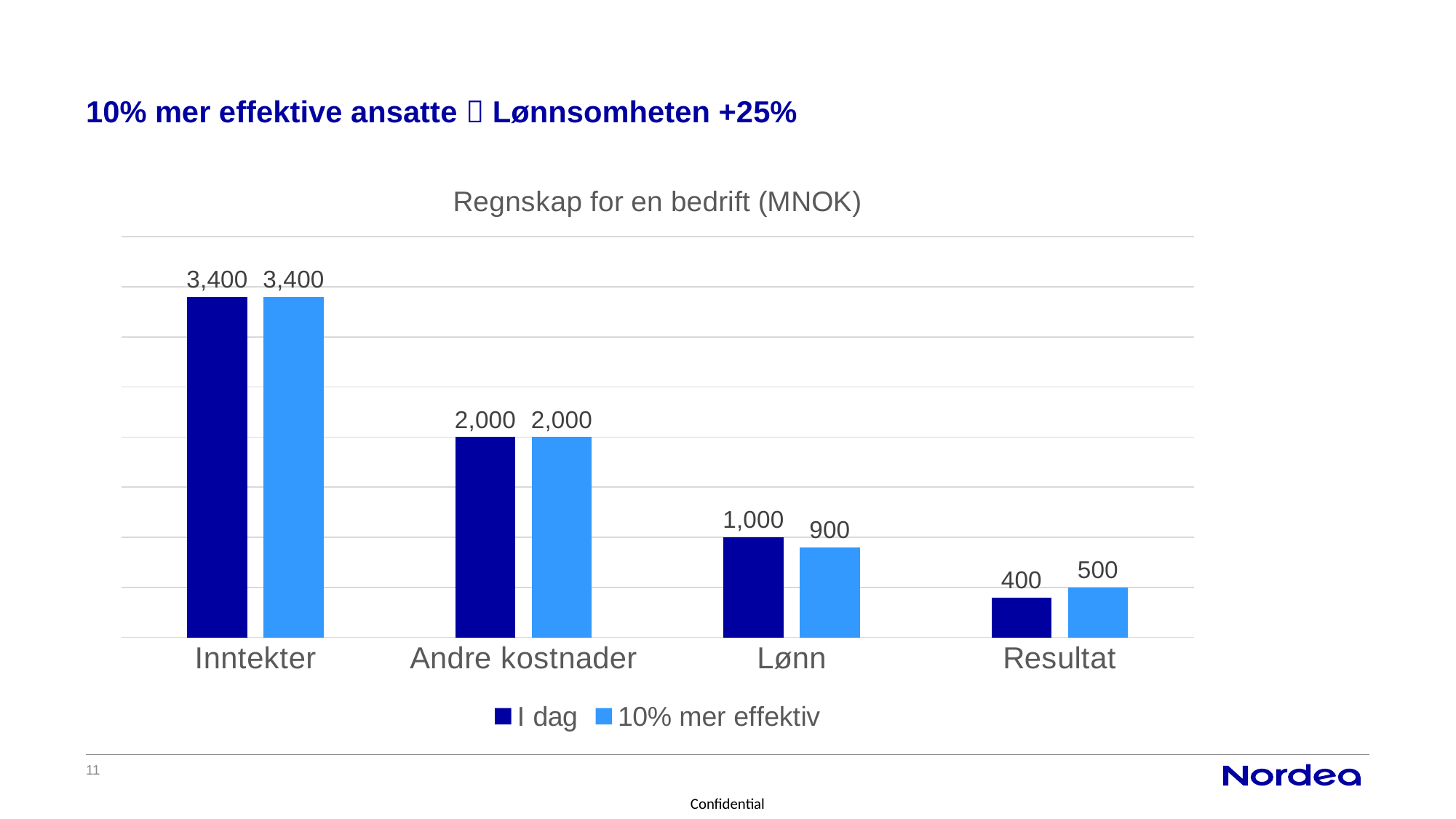
How many categories are shown on the x axis? 4 Which category has the highest value in the 'I dag' series? Inntekter How many series does the legend list? 2 What is the value for Andre kostnader in the '10% mer effektiv' series? 2,000 What is the value for Lønn in the '10% mer effektiv' series? 900 What type of chart is shown on the slide? Bar chart Which category has the lowest value in the '10% mer effektiv' series? Resultat What is the value for Resultat in the 'I dag' series? 400 What is the value for Inntekter in the 'I dag' series? 3,400 What is the difference between the 'I dag' and '10% mer effektiv' values for Lønn? 100 What is the difference between the '10% mer effektiv' and 'I dag' values for Resultat? 100 For Resultat, which series has the larger value: 'I dag' or '10% mer effektiv'? 10% mer effektiv